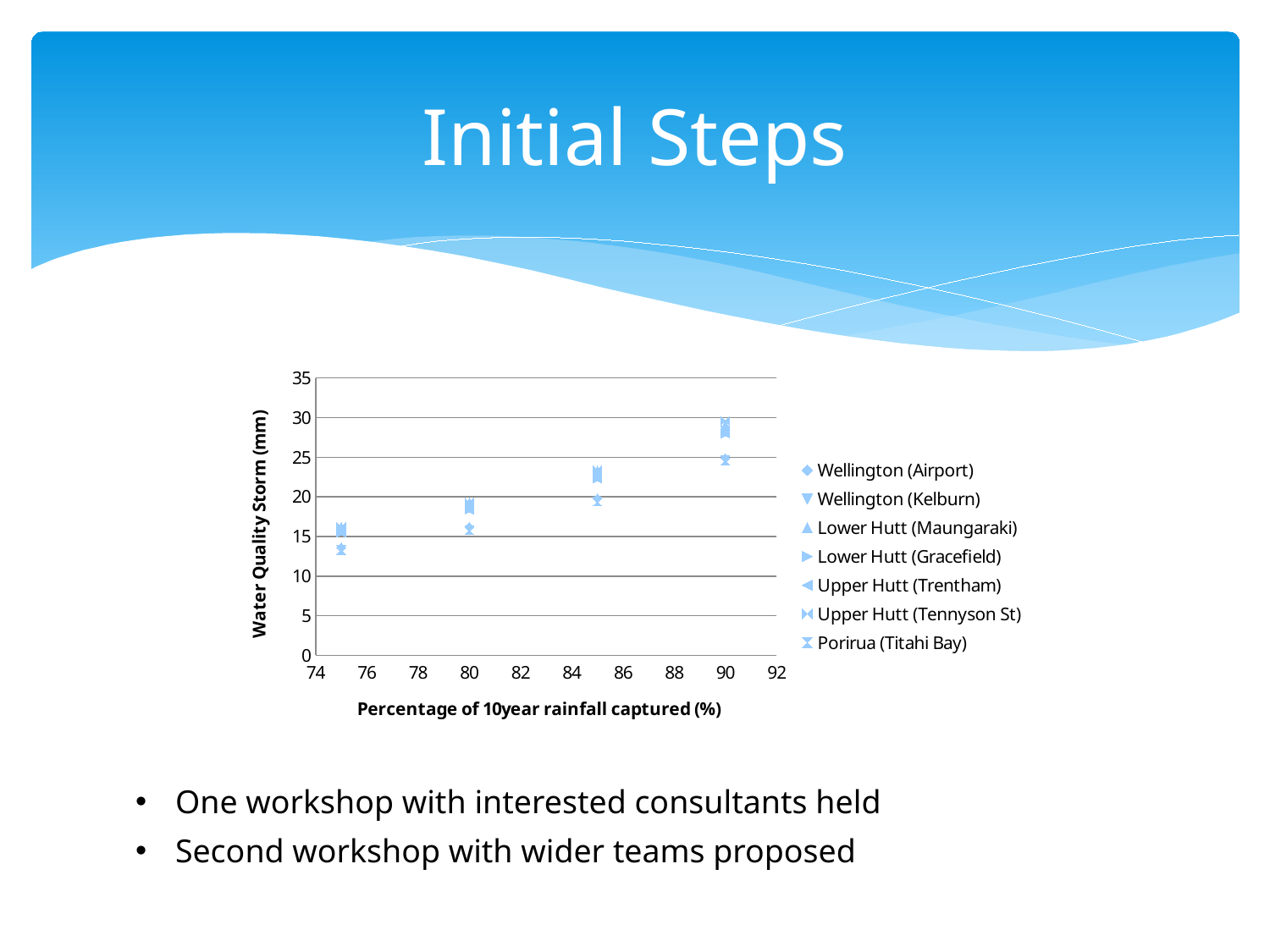
What kind of chart is shown on the slide? scatter chart Do the Water Quality Storm values rise or fall as the percentage of rainfall captured increases? rise Is the value for Lower Hutt (Maungaraki) at 85% rainfall captured greater or less than 20? greater What is the label of the x axis? Percentage of 10year rainfall captured (%) Is the value for Porirua (Titahi Bay) at 75% rainfall captured greater or less than 15? less Is the value for Wellington (Kelburn) at 75% rainfall captured greater or less than 20? less How many series does the legend list? 7 What is the label of the y axis? Water Quality Storm (mm) At how many distinct percentage values on the x axis are data points plotted? 4